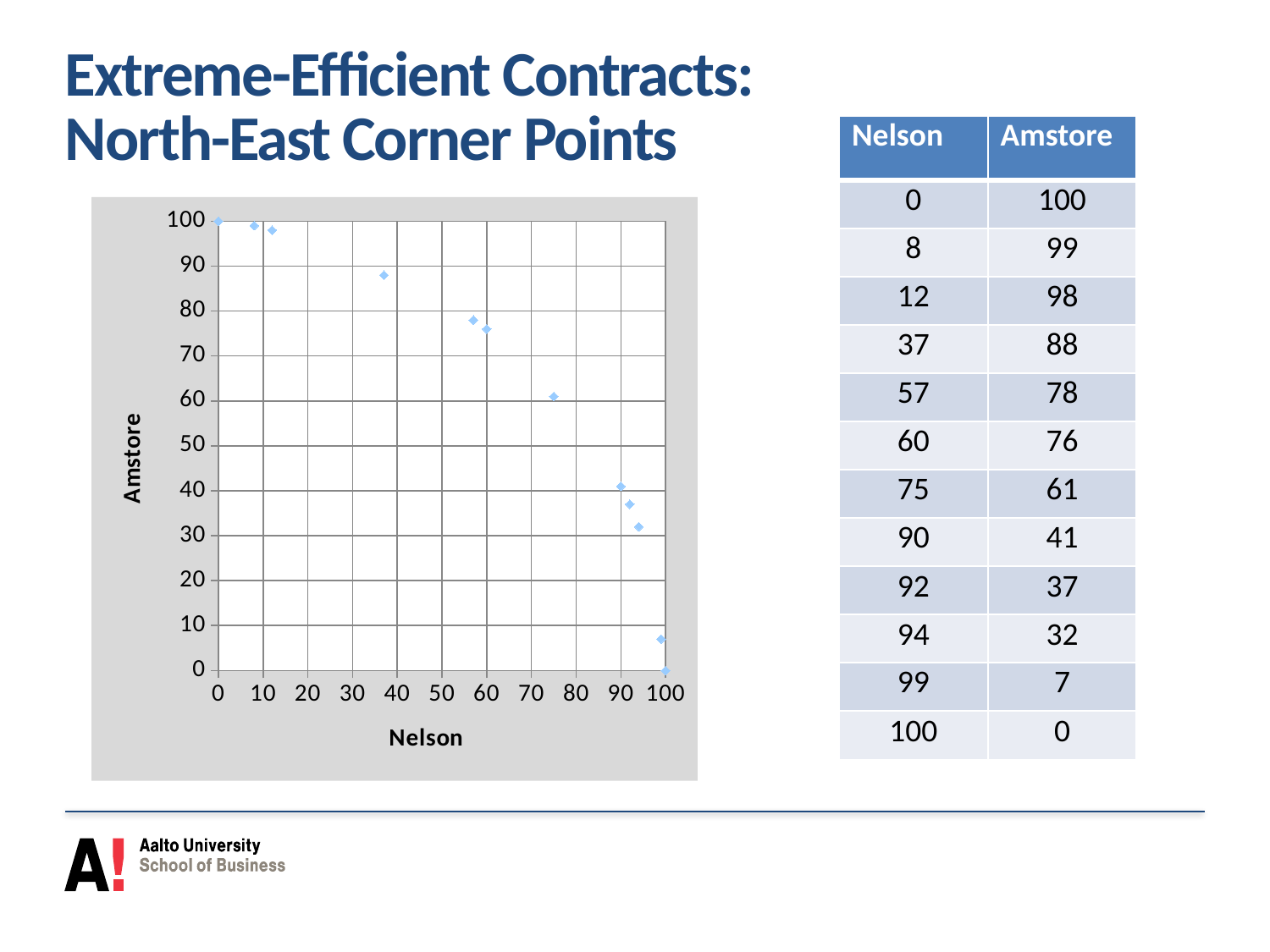
Which Nelson value has the lowest Amstore value? 100 Which Nelson value has the highest Amstore value? 0 What is the label of the x axis of the chart? Nelson What is the label of the y axis of the chart? Amstore What is the difference in Amstore between the points at Nelson 57 and Nelson 90? 37 What is the Amstore value when Nelson is 37? 88 What is the Nelson value of the point where Amstore is 32? 94 Which has a larger Amstore value: the point at Nelson 12 or the point at Nelson 60? Nelson 12 What is the Amstore value when Nelson is 75? 61 What kind of chart is shown on the slide? scatter chart Do the Amstore values rise or fall as Nelson increases along the x axis? fall How many data points are plotted on the chart? 12